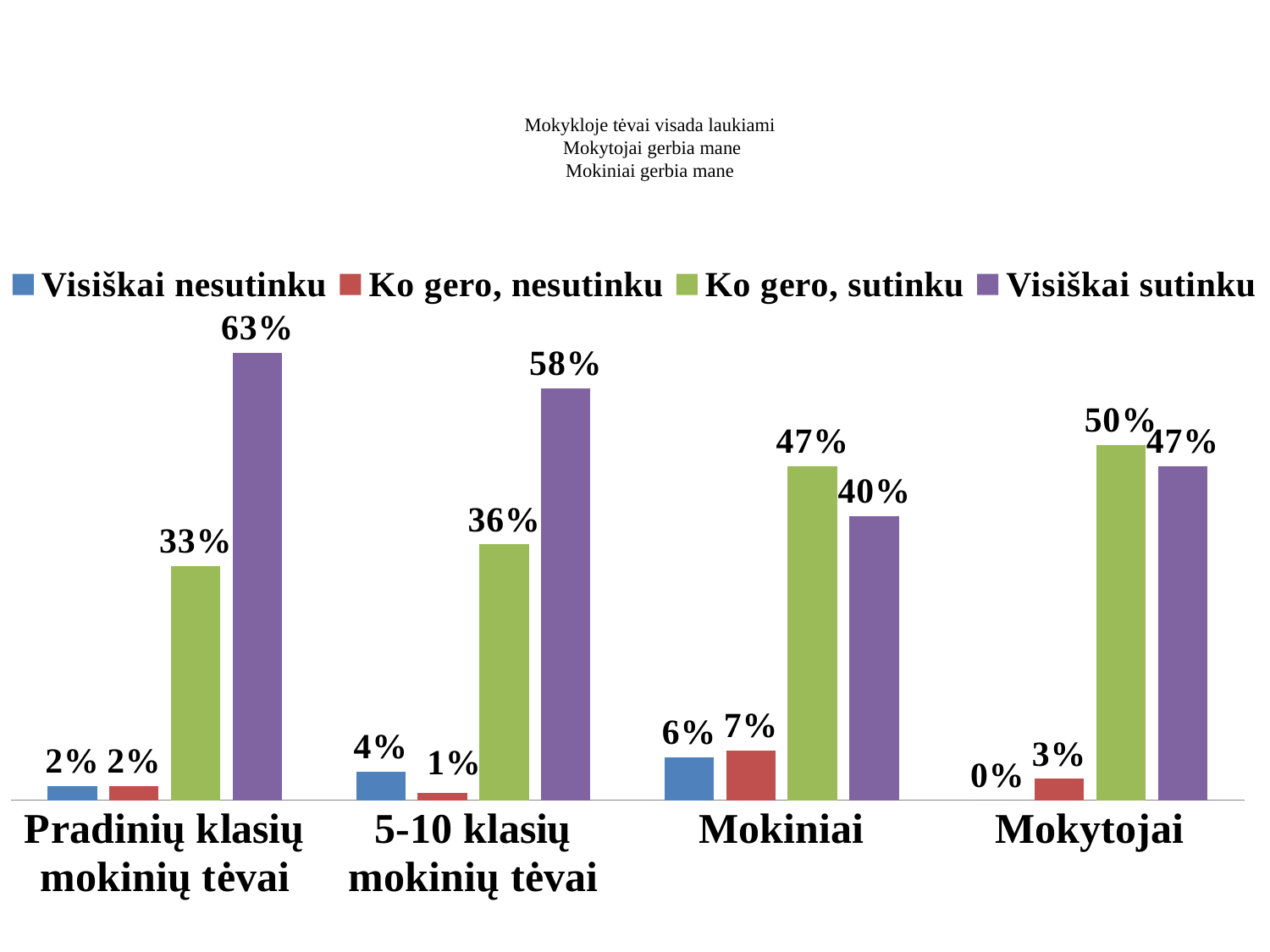
Which category has the highest value for "Visiškai sutinku"? Pradinių klasių mokinių tėvai What is the value for "Ko gero, nesutinku" in the "Mokiniai" category? 7% What is the value for "Visiškai sutinku" in the "Pradinių klasių mokinių tėvai" category? 63% What is the value for "Ko gero, sutinku" in the "Mokytojai" category? 50% What kind of chart is shown on the slide? Bar chart What is the value for "Visiškai nesutinku" in the "Mokytojai" category? 0% Which category has the lowest value for "Ko gero, sutinku"? Pradinių klasių mokinių tėvai Which legend entry is shown in purple? Visiškai sutinku How many series does the legend list? 4 Which is larger in the "Mokiniai" category: "Ko gero, sutinku" or "Visiškai sutinku"? Ko gero, sutinku How many categories are shown on the x axis? 4 What is the difference between the "Visiškai sutinku" values for "Pradinių klasių mokinių tėvai" and "5-10 klasių mokinių tėvai"? 5%